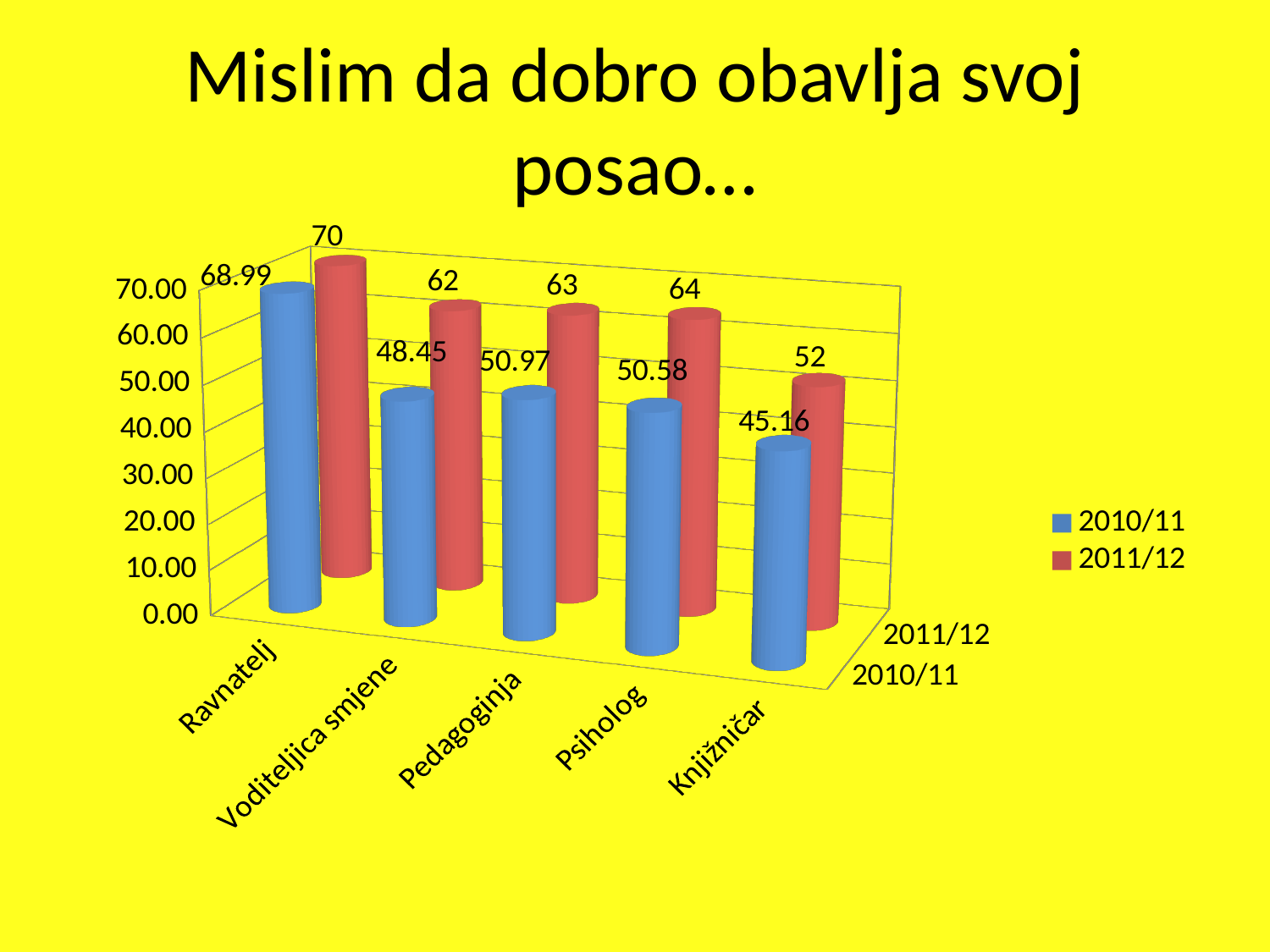
What is the value for Psiholog in the 2011/12 series? 64 Which is larger for Pedagoginja: the 2010/11 value or the 2011/12 value? 2011/12 How many series does the legend list? 2 What is the value for Knjižničar in the 2010/11 series? 45.16 How many categories are shown on the x axis? 5 Which category has the lowest value in the 2010/11 series? Knjižničar What kind of chart is shown on the slide? Bar chart What is the value for Voditeljica smjene in the 2011/12 series? 62 What is the difference between the 2011/12 and 2010/11 values for Voditeljica smjene? 13.55 What is the value for Ravnatelj in the 2010/11 series? 68.99 Which colour represents the 2011/12 series? Red Which category has the highest value in the 2011/12 series? Ravnatelj